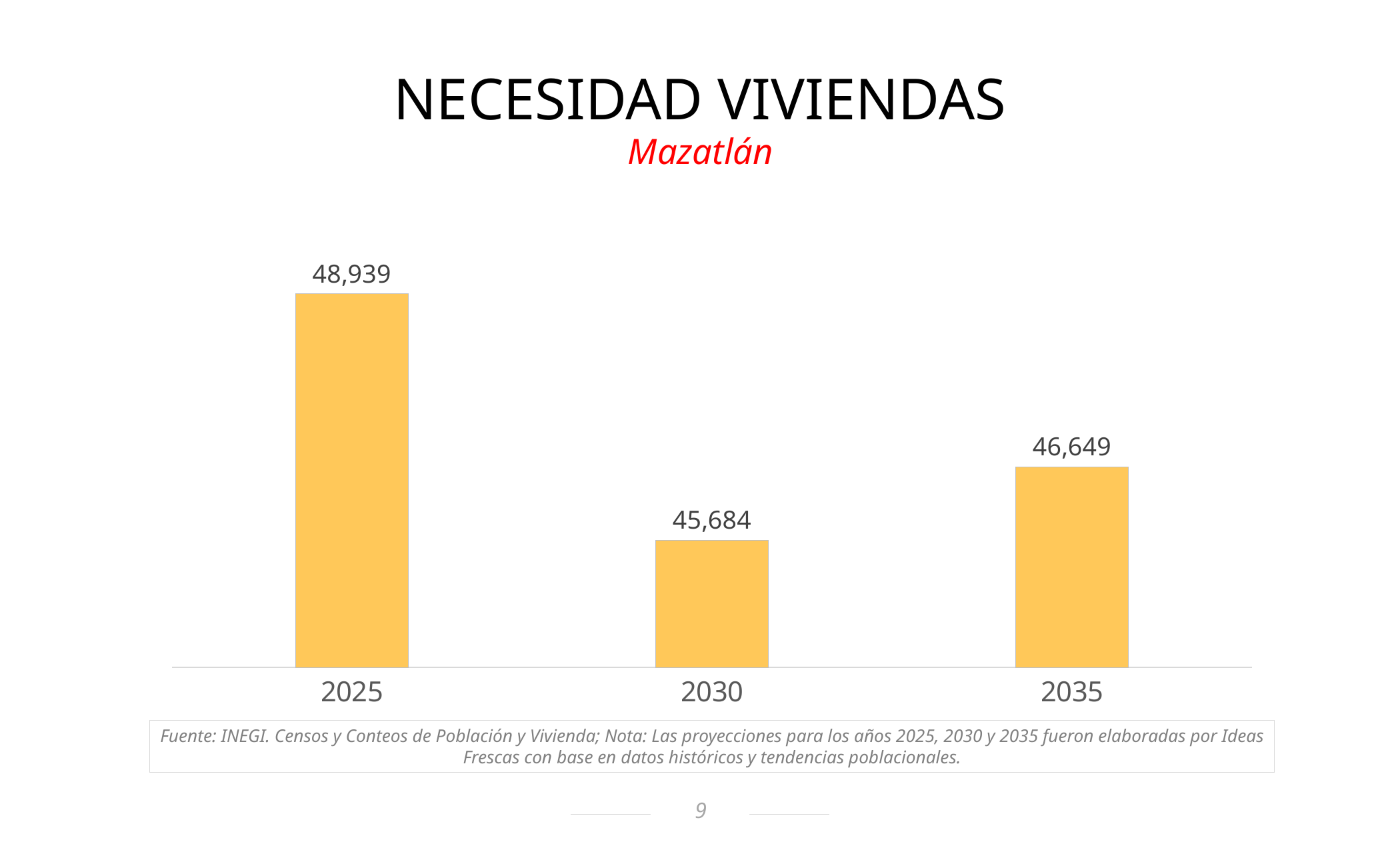
What is the value for 2035? 46,649 What is the value for 2025? 48,939 What is the title of the chart? NECESIDAD VIVIENDAS Mazatlán Which year has the lowest value? 2030 What kind of chart is shown on the slide? bar chart How many years are shown on the chart? 3 What is the difference between the values for 2035 and 2030? 965 Which year has the highest value? 2025 What is the value for 2030? 45,684 Which is larger, the value for 2025 or the value for 2035? 2025 What is the difference between the values for 2025 and 2030? 3,255 Does the value rise or fall from 2025 to 2030? fall